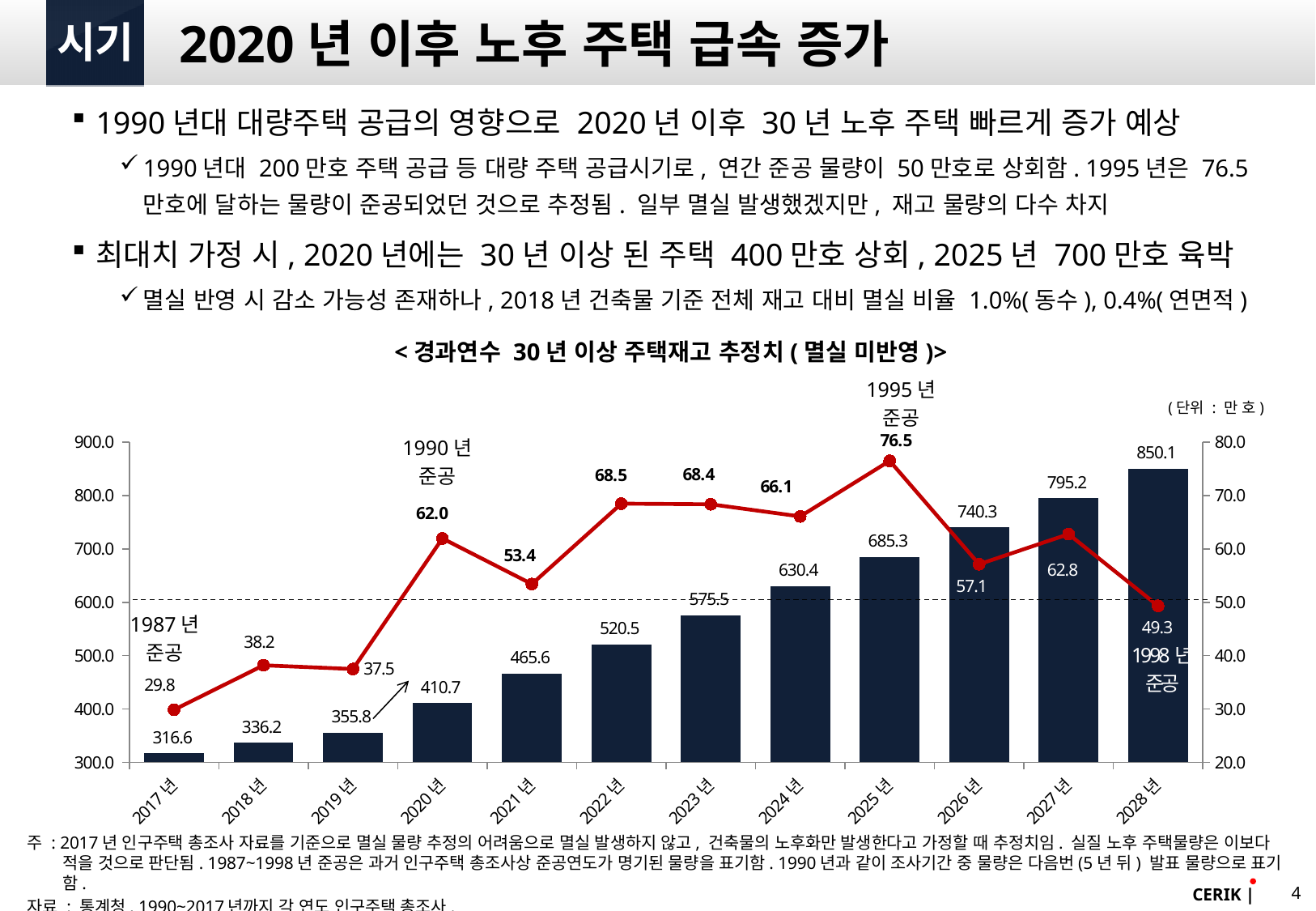
What is the bar value for 2028년? 850.1 Do the bar values rise or fall from 2017년 to 2028년? rise What is the title of the chart? 경과연수 30년 이상 주택재고 추정치 (멸실 미반영) Which year has the lowest red line point? 2017년 What is the value of the red line point at 2017년? 29.8 What unit is stated for the chart values? 만 호 What is the bar value for 2020년 in the chart? 410.7 Which is larger, the red line value at 2022년 or at 2024년? 2022년 Which year has the highest bar in the chart? 2028년 What is the difference between the bar values for 2028년 and 2017년? 533.5 How many years are shown on the x axis of the chart? 12 What is the value of the red line point labelled for 2025년 (1995년 준공)? 76.5